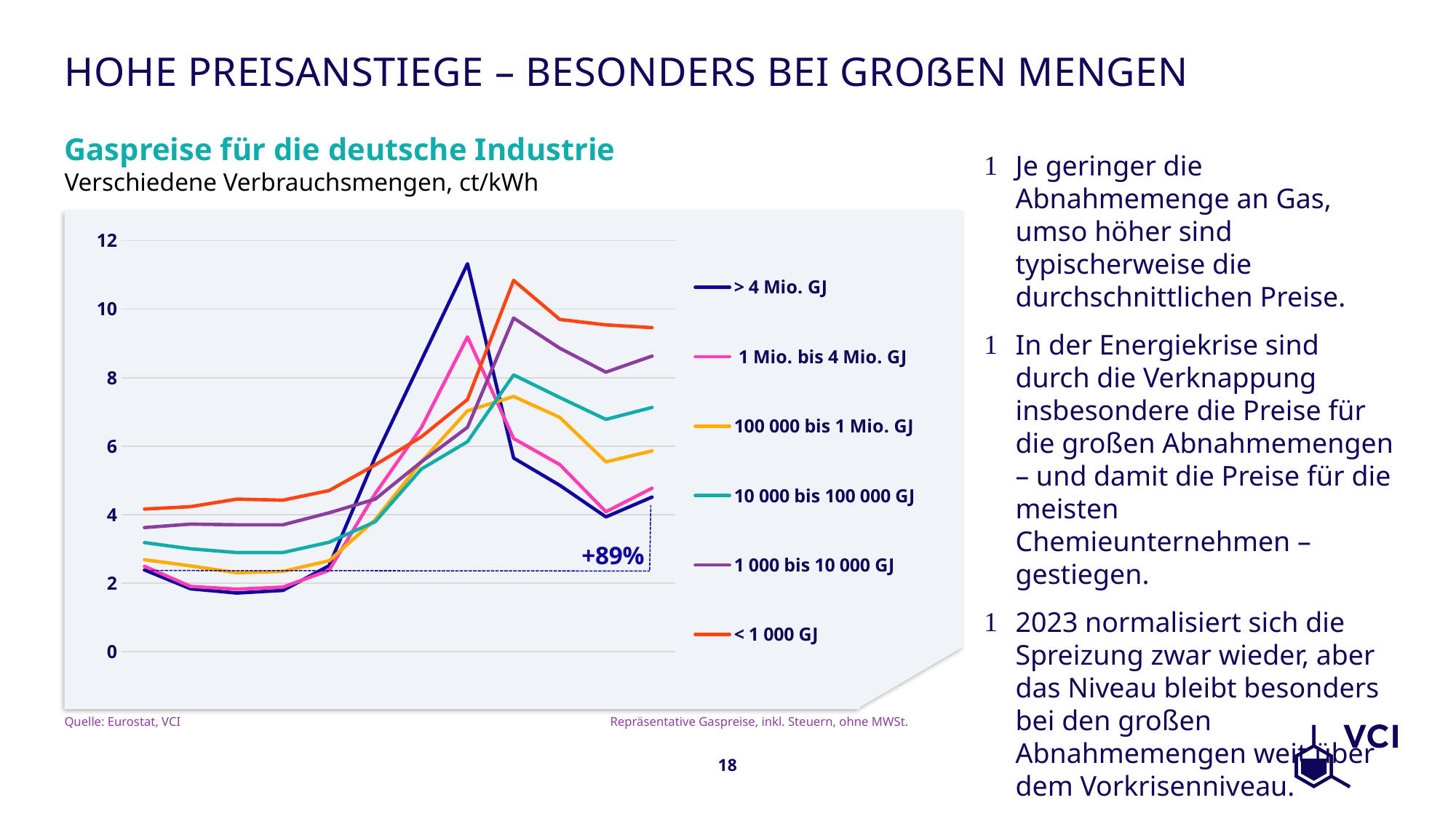
Is the peak value of the '1 Mio. bis 4 Mio. GJ' series greater or less than 10? less Which series reaches the highest value anywhere on the chart? > 4 Mio. GJ What percentage increase is annotated on the chart for the '> 4 Mio. GJ' series? +89% At the point where the '> 4 Mio. GJ' series peaks, which is higher, '> 4 Mio. GJ' or '< 1 000 GJ'? > 4 Mio. GJ How many series does the legend of the chart list? 6 Which series has the highest value at the last point on the x axis? < 1 000 GJ What is the title of the chart? Gaspreise für die deutsche Industrie What kind of chart is shown on the slide? line chart Is the peak value of the '> 4 Mio. GJ' series greater or less than 10? greater Is the peak value of the '10 000 bis 100 000 GJ' series greater or less than 10? less Which series is drawn in orange in the chart? < 1 000 GJ